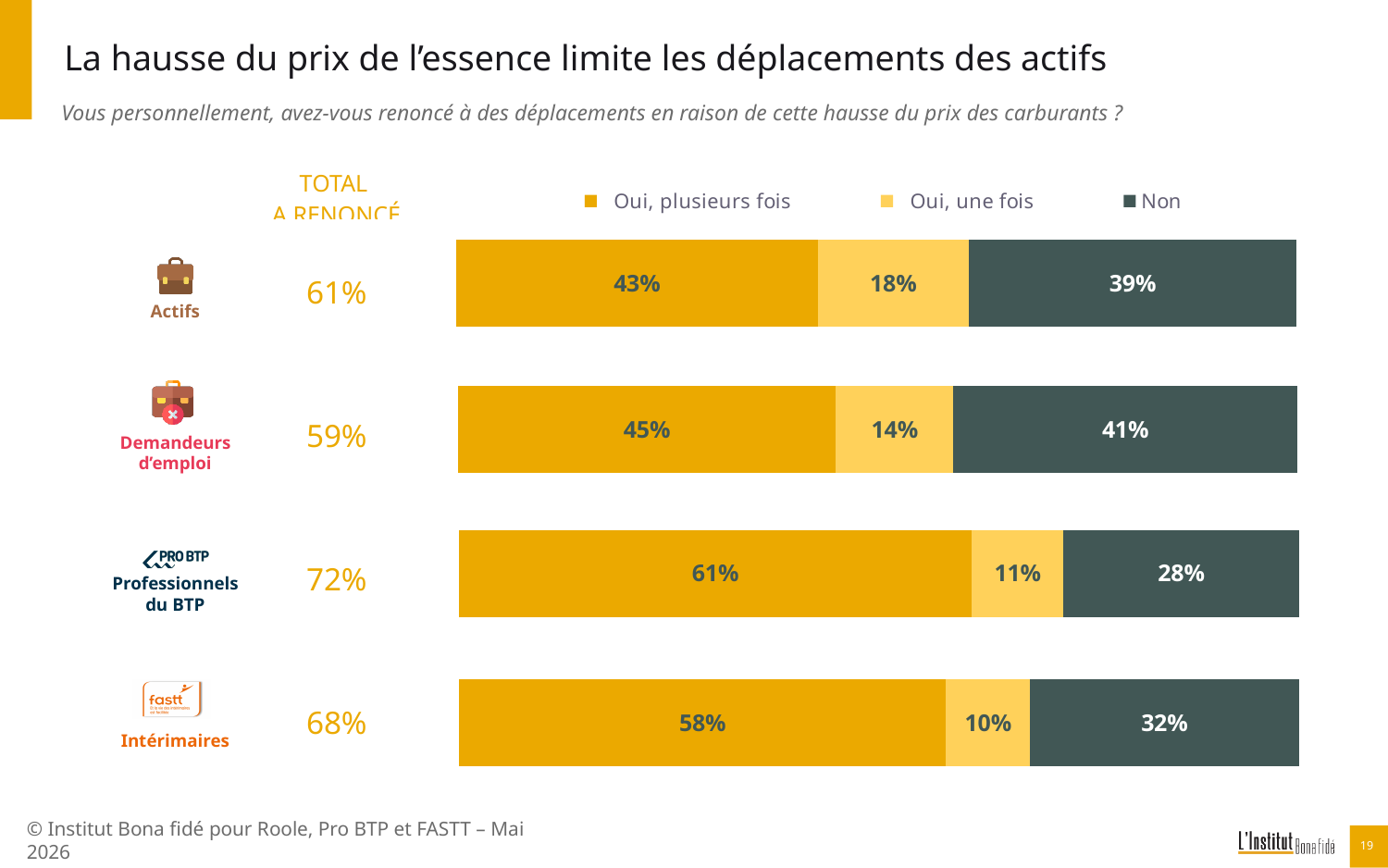
Which category has the highest share of "Oui, plusieurs fois"? Professionnels du BTP What is the difference between the "Non" share for Actifs and for Professionnels du BTP? 11 percentage points What percentage of Demandeurs d'emploi answered "Non"? 41% What kind of chart is shown on the slide? Stacked bar chart What is the combined share of "Oui, plusieurs fois" and "Oui, une fois" for Intérimaires? 68% Which category has the lowest share of "Non"? Professionnels du BTP Which legend entry is shown in dark grey-green? Non Which is larger: the "Oui, une fois" share for Actifs or for Demandeurs d'emploi? Actifs How many series does the legend list? 3 What percentage of Intérimaires answered "Oui, une fois"? 10% How many categories (groups) are shown in the chart? 4 What percentage of Actifs answered "Oui, plusieurs fois"? 43%